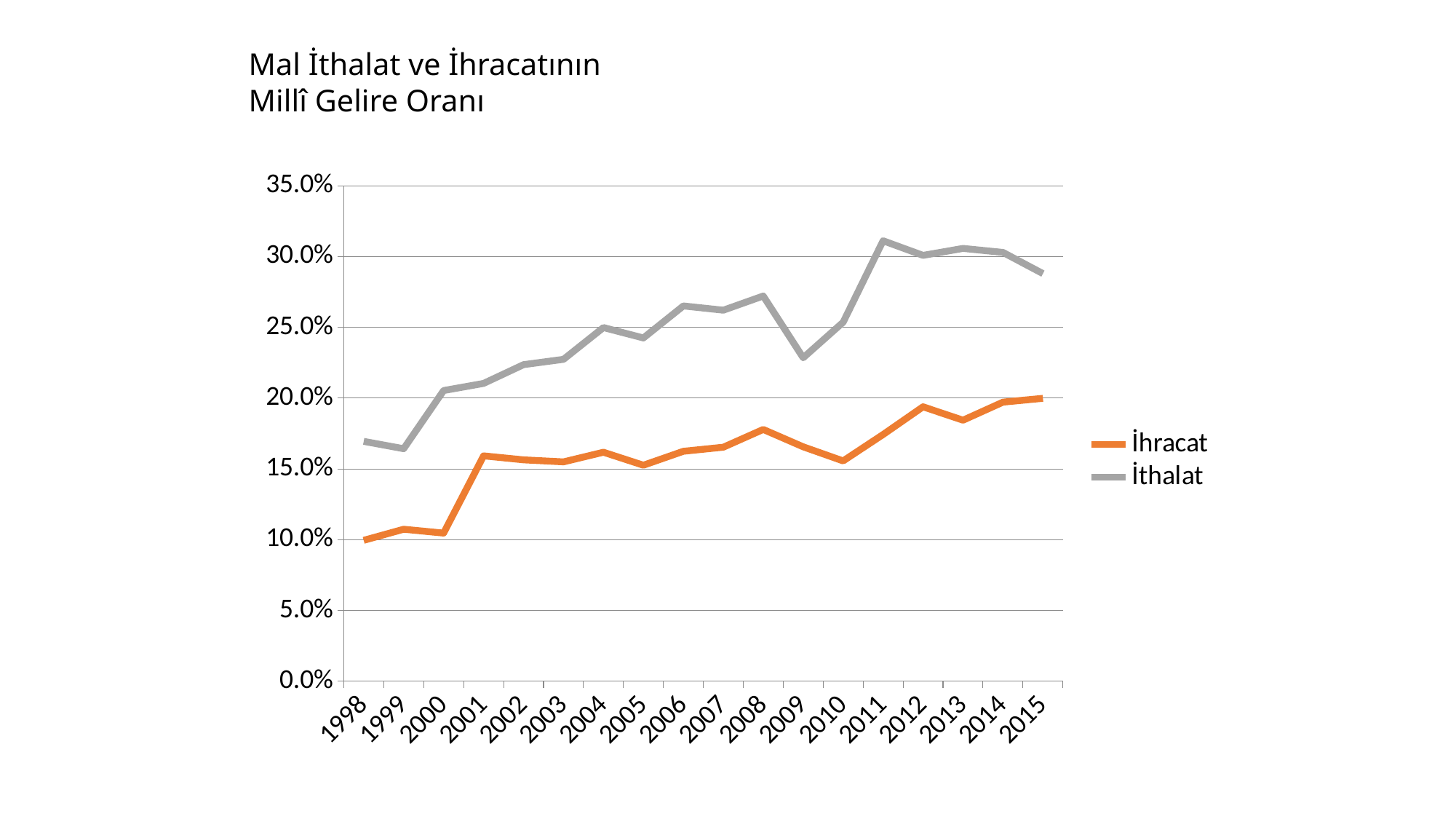
Is the value for İhracat in 2001 greater or less than 15.0%? greater How many series does the legend list? 2 Is the value for İthalat in 2011 greater or less than 30.0%? greater In 2008, which series has the larger value, İhracat or İthalat? İthalat Is the value for İthalat in 2009 greater or less than 25.0%? less Does the İthalat line generally rise or fall from 1998 to 2015? rise What kind of chart is shown on the slide? line chart Which year has the highest value for İthalat? 2011 Which year has the lowest value for İhracat? 1998 How many years are shown on the x axis? 18 Which colour is used for the İhracat series? orange